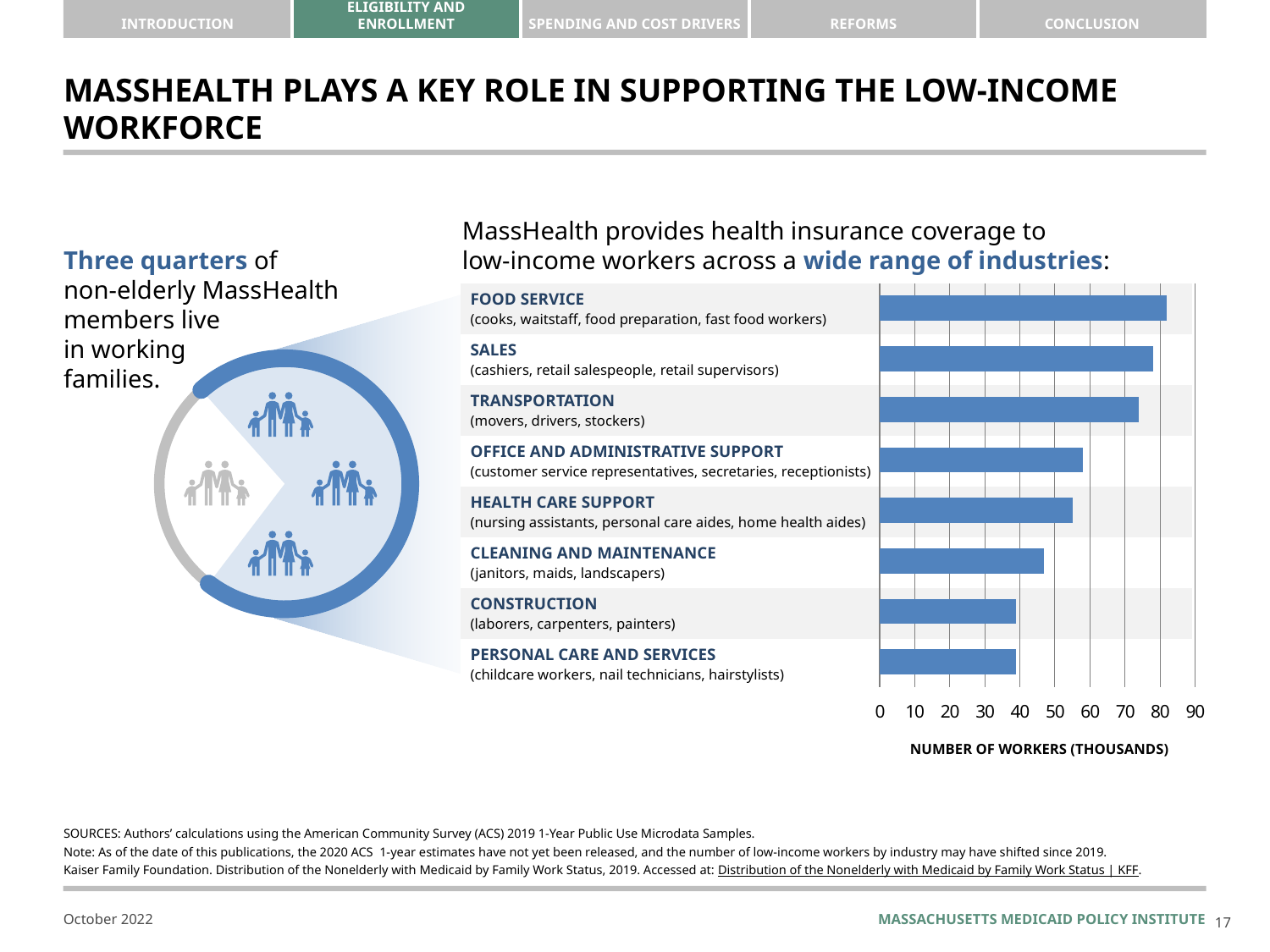
Is the value for Office and administrative support greater or less than 50? greater What is the label of the horizontal axis of the bar chart? Number of workers (thousands) Is the value for Cleaning and maintenance greater or less than 50? less Is the value for Transportation greater or less than 80? less Which industry has the highest number of workers in the bar chart? Food service What kind of chart is shown on the right side of the slide? bar chart Which has more workers, Sales or Health care support? Sales Which has more workers, Cleaning and maintenance or Transportation? Transportation How many industry categories are plotted in the bar chart? 8